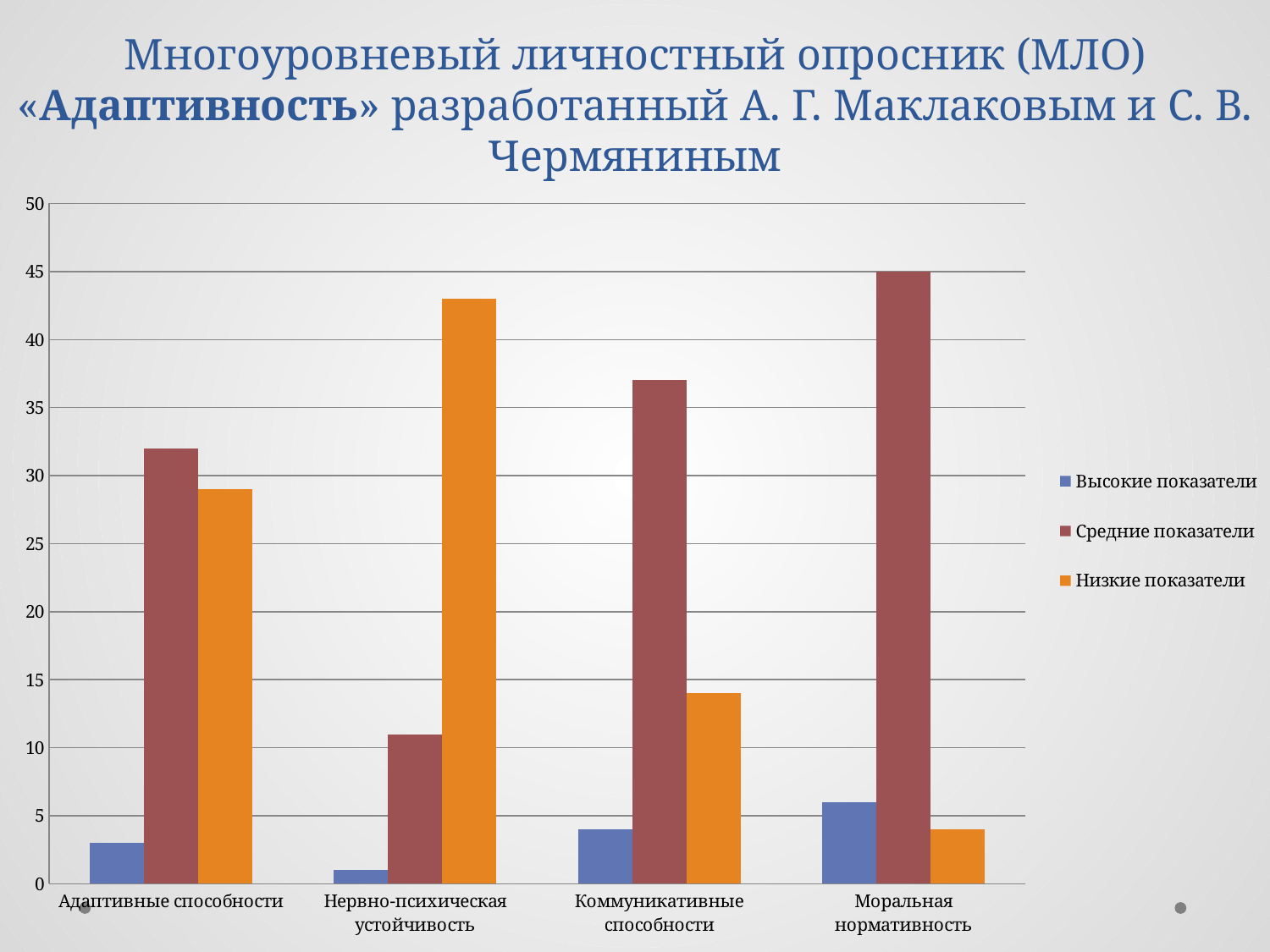
Which category has the highest value for Низкие показатели? Нервно-психическая устойчивость For Адаптивные способности, which is larger: Средние показатели or Низкие показатели? Средние показатели Which category has the highest value for Средние показатели? Моральная нормативность Is the value of Низкие показатели for Нервно-психическая устойчивость greater or less than 40? greater What kind of chart is shown on the slide? bar chart How many series does the legend list? 3 How many categories are shown on the x axis? 4 What is the value of Средние показатели for Моральная нормативность? 45 Which category has the lowest value for Высокие показатели? Нервно-психическая устойчивость Which legend entry is shown in orange? Низкие показатели Is the value of Низкие показатели for Коммуникативные способности greater or less than 15? less Is the value of Средние показатели for Коммуникативные способности greater or less than 35? greater